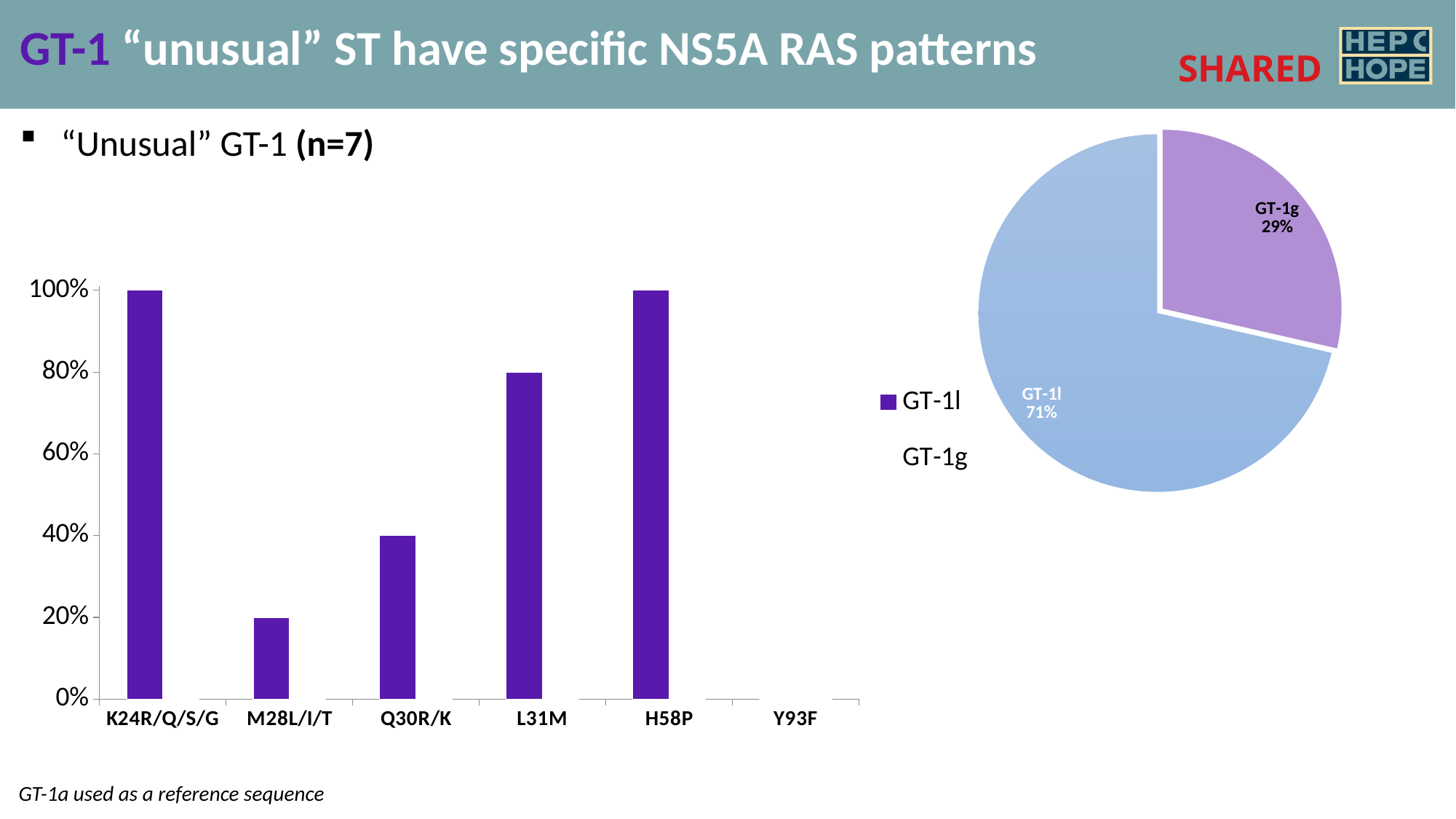
In the bar chart on the left, which is larger, the value for Q30R/K or the value for L31M? L31M In the bar chart on the left, what is the difference between the values for L31M and M28L/I/T? 60% In the bar chart on the left, which category has the lowest value? Y93F In the bar chart on the left, what is the value for L31M? 80% In the pie chart on the right, what share does GT-1l have? 71% In the bar chart on the left, what is the value for Q30R/K? 40% What kind of chart is shown on the left of the slide? bar chart How many categories are shown on the x axis of the bar chart on the left? 6 In the bar chart on the left, what is the value for M28L/I/T? 20% How many entries does the legend of the pie chart on the right list? 2 In the pie chart on the right, what share does GT-1g have? 29% In the bar chart on the left, is the value for Q30R/K greater or less than 60%? less